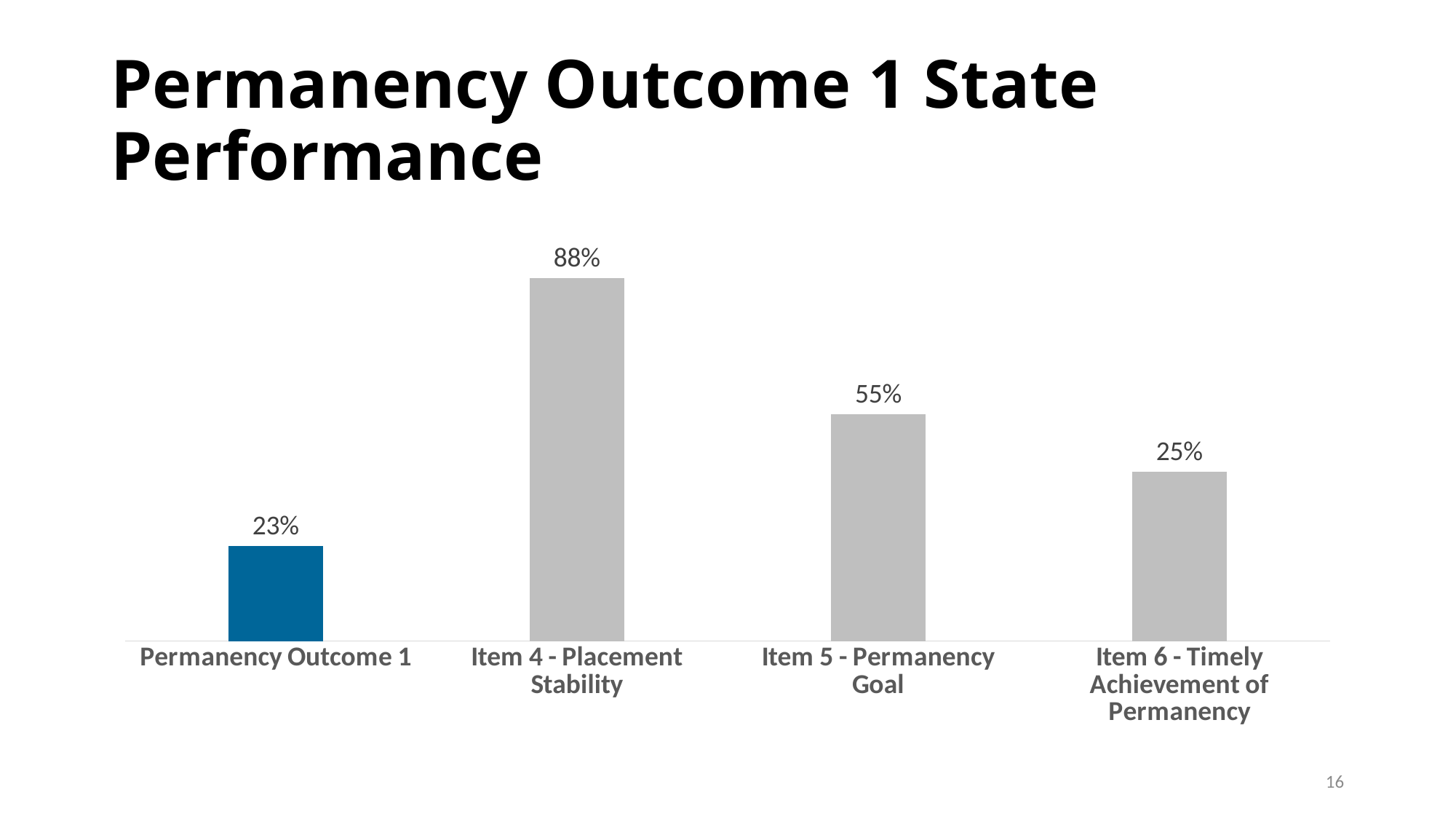
Which is larger, the value for Item 5 - Permanency Goal or the value for Item 6 - Timely Achievement of Permanency? Item 5 - Permanency Goal What is the difference between the values for Item 6 - Timely Achievement of Permanency and Permanency Outcome 1? 2% Which bar is coloured blue rather than grey? Permanency Outcome 1 Which category has the lowest value? Permanency Outcome 1 What is the value for Item 4 - Placement Stability? 88% How many categories are shown in the chart? 4 What kind of chart is shown on the slide? Bar chart Which category has the highest value? Item 4 - Placement Stability What is the value for Item 5 - Permanency Goal? 55% What is the value for Permanency Outcome 1? 23% What is the value for Item 6 - Timely Achievement of Permanency? 25% What is the difference between the values for Item 4 - Placement Stability and Item 5 - Permanency Goal? 33%